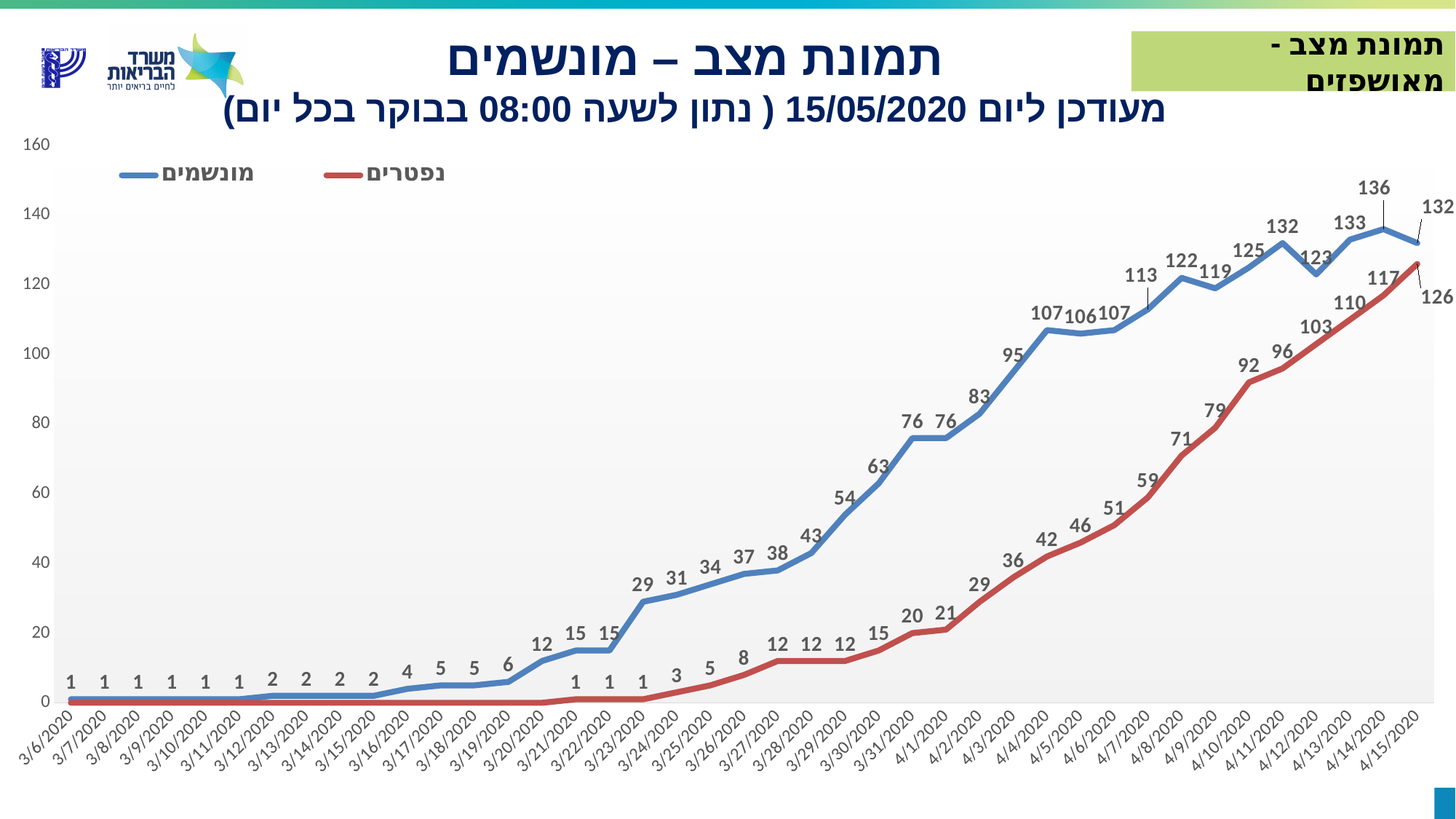
What is the highest value of the מונשמים series? 136 What is the difference between the מונשמים and נפטרים values on 4/15/2020? 6 Which series has the larger value on 4/8/2020, מונשמים or נפטרים? מונשמים What is the value of the נפטרים series on 4/15/2020? 126 Which series is drawn in red? נפטרים On which date does the מונשמים series reach its highest value? 4/14/2020 How many series does the legend list? 2 What is the value of the מונשמים series on 4/15/2020? 132 What type of chart is shown on the slide? line chart What is the value of the מונשמים series on 4/4/2020? 107 Does the נפטרים series generally rise or fall from 3/21/2020 to 4/15/2020? rise What is the value of the נפטרים series on 4/10/2020? 92